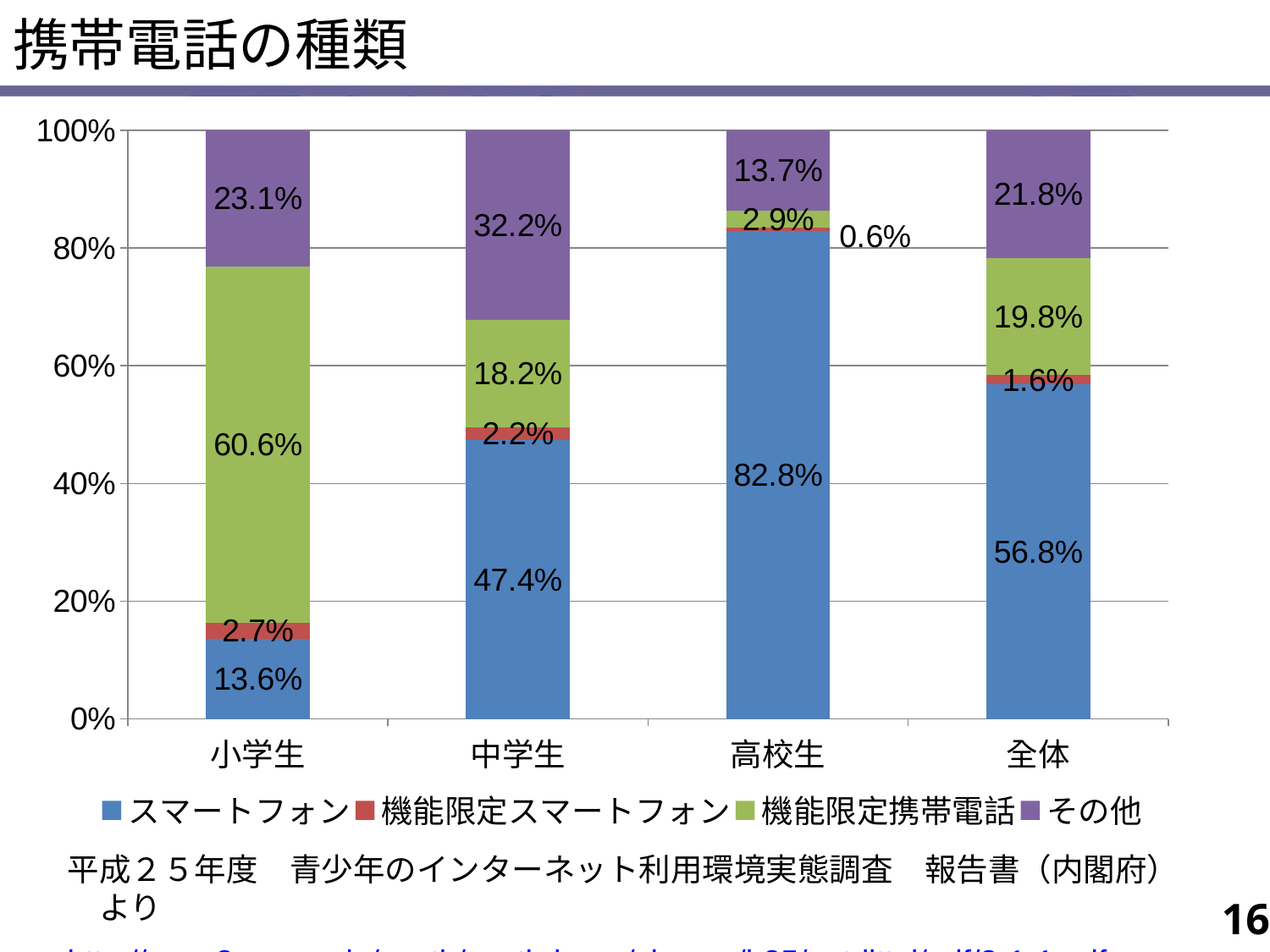
What kind of chart is shown on the slide? Stacked bar chart What is the その他 value for 中学生? 32.2% Does the スマートフォン share rise or fall from 小学生 to 高校生? Rise Which category has the highest スマートフォン share? 高校生 What is the 機能限定携帯電話 value for 小学生? 60.6% How many categories are shown on the x axis? 4 How many series does the legend list? 4 What is the スマートフォン value for 高校生? 82.8% Which category has the lowest スマートフォン share? 小学生 What is the 機能限定スマートフォン value for 全体? 1.6% Which is larger, the その他 value for 小学生 or for 全体? 小学生 What is the difference between the スマートフォン values for 高校生 and 中学生? 35.4%